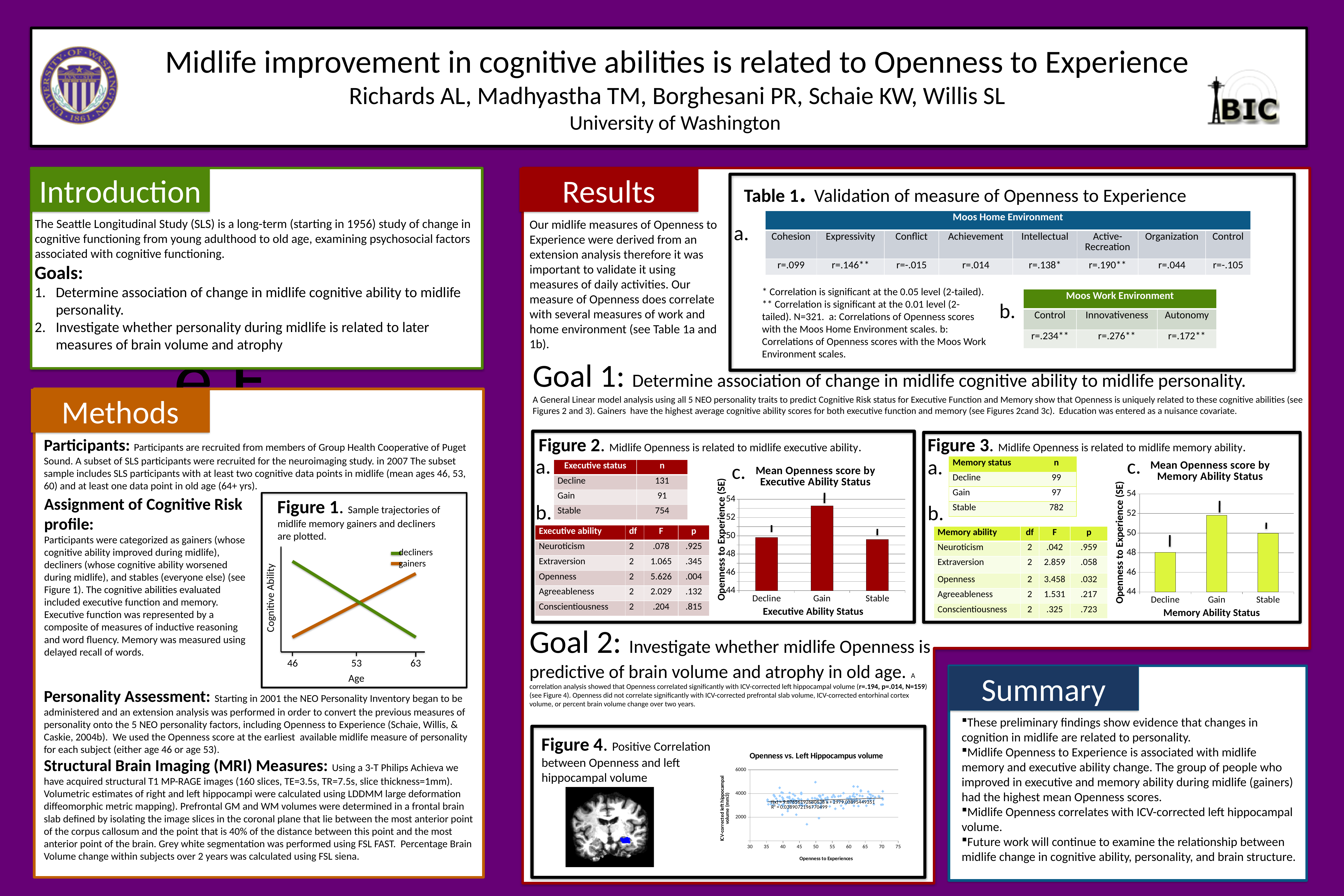
In Figure 3c (Mean Openness score by Memory Ability Status), which memory status has the highest mean Openness score? Gain In Figure 3c (Mean Openness score by Memory Ability Status), which is larger, the value for Stable or the value for Decline? Stable In Figure 3c (Mean Openness score by Memory Ability Status), which memory status has the lowest mean Openness score? Decline In Figure 2c (Mean Openness score by Executive Ability Status), which status has the highest mean Openness score? Gain In Figure 2c (Mean Openness score by Executive Ability Status), how many executive ability status categories are plotted? 3 In Figure 2c (Mean Openness score by Executive Ability Status), is the value for Decline greater or less than 52? less In Figure 2c (Mean Openness score by Executive Ability Status), what kind of chart is shown? bar chart In Figure 4 (Openness vs. Left Hippocampus volume), what kind of chart is shown? scatter plot In Figure 2c (Mean Openness score by Executive Ability Status), is the value for Gain greater or less than 52? greater In Figure 3c (Mean Openness score by Memory Ability Status), is the value for Gain greater or less than 50? greater In Figure 1 (Sample trajectories of midlife memory gainers and decliners), how many series does the legend list? 2 In Figure 1 (Sample trajectories of midlife memory gainers and decliners), does the decliners line rise or fall as age increases? fall